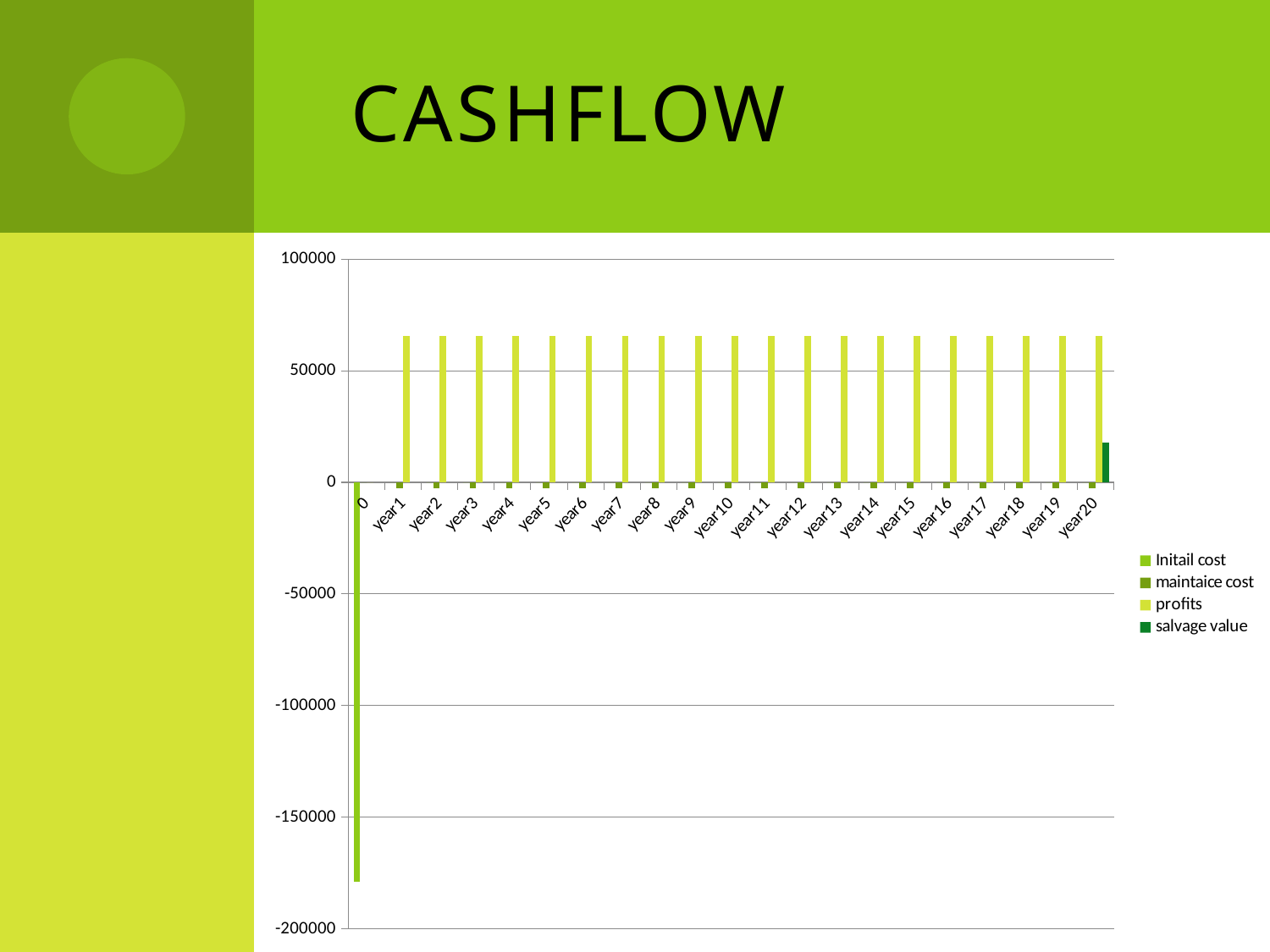
How many categories are shown along the x axis of the CASHFLOW chart? 21 Do the profits values rise, fall or stay flat from year1 to year20? stay flat How many series does the legend of the CASHFLOW chart list? 4 Is the value for Initail cost at category 0 greater or less than -150000? less What is the title of the slide containing the chart? CASHFLOW Is the value for profits in year3 greater or less than 50000? greater Is the value for profits in year10 greater or less than 100000? less Which series has the lowest value on the CASHFLOW chart? Initail cost Which series is listed last in the legend of the CASHFLOW chart? salvage value What kind of chart is shown on the CASHFLOW slide? bar chart Which is larger: the profits value in year5 or the salvage value in year20? profits in year5